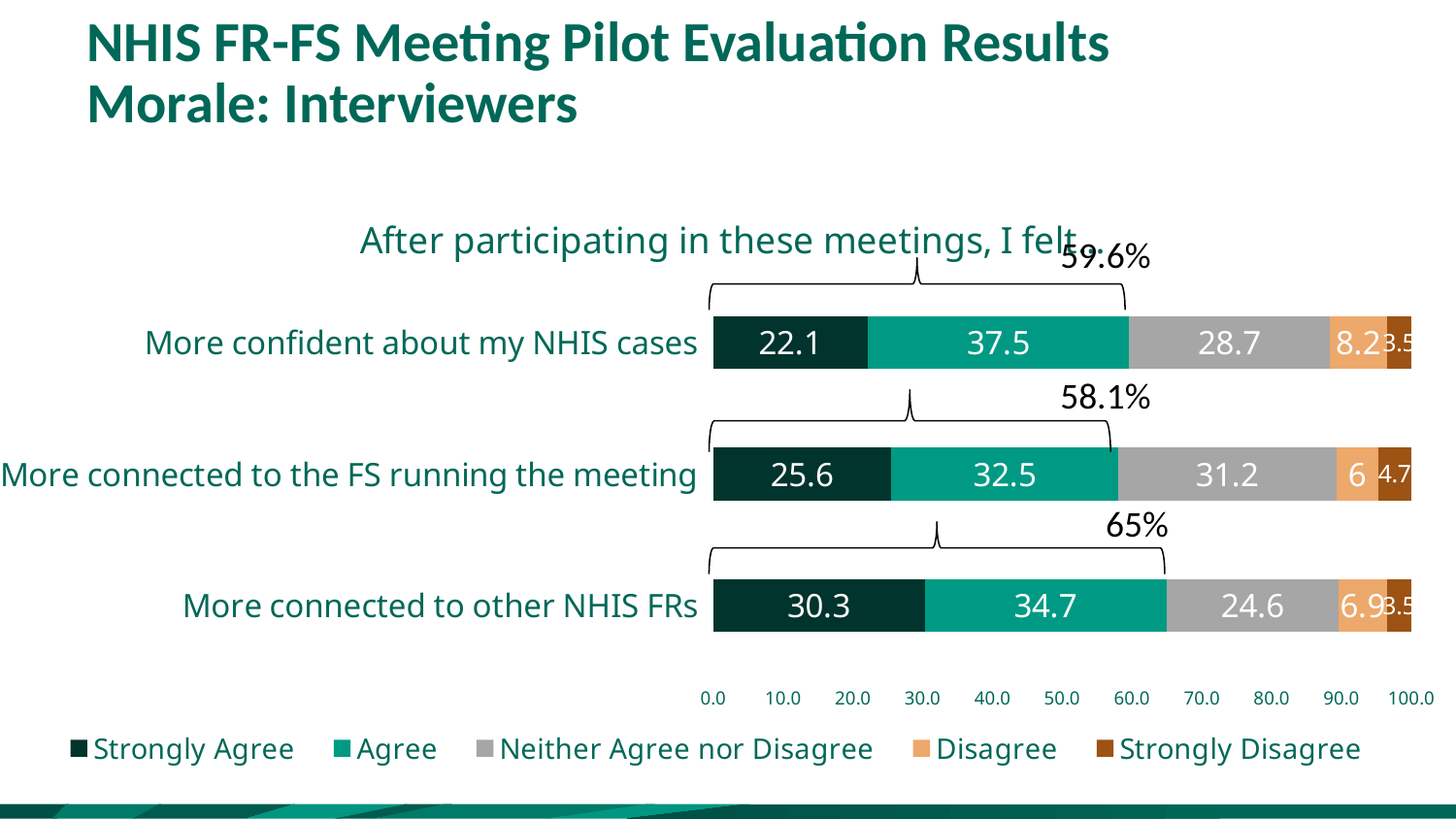
What kind of chart is shown on the slide? stacked bar chart Which is larger: the Disagree value for "More confident about my NHIS cases" or for "More connected to other NHIS FRs"? More confident about my NHIS cases Which statement has the lowest Neither Agree nor Disagree value? More connected to other NHIS FRs How many categories (statements) are plotted on the chart? 3 What is the Agree value for "More connected to the FS running the meeting"? 32.5 What is the difference between the Agree values for "More confident about my NHIS cases" and "More connected to the FS running the meeting"? 5 What is the Strongly Agree value for "More confident about my NHIS cases"? 22.1 What is the Neither Agree nor Disagree value for "More connected to other NHIS FRs"? 24.6 Which statement has the highest Strongly Agree value? More connected to other NHIS FRs What combined Strongly Agree and Agree percentage is shown above the bar for "More connected to other NHIS FRs"? 65% What is the title of the chart? After participating in these meetings, I felt... How many series does the legend list? 5